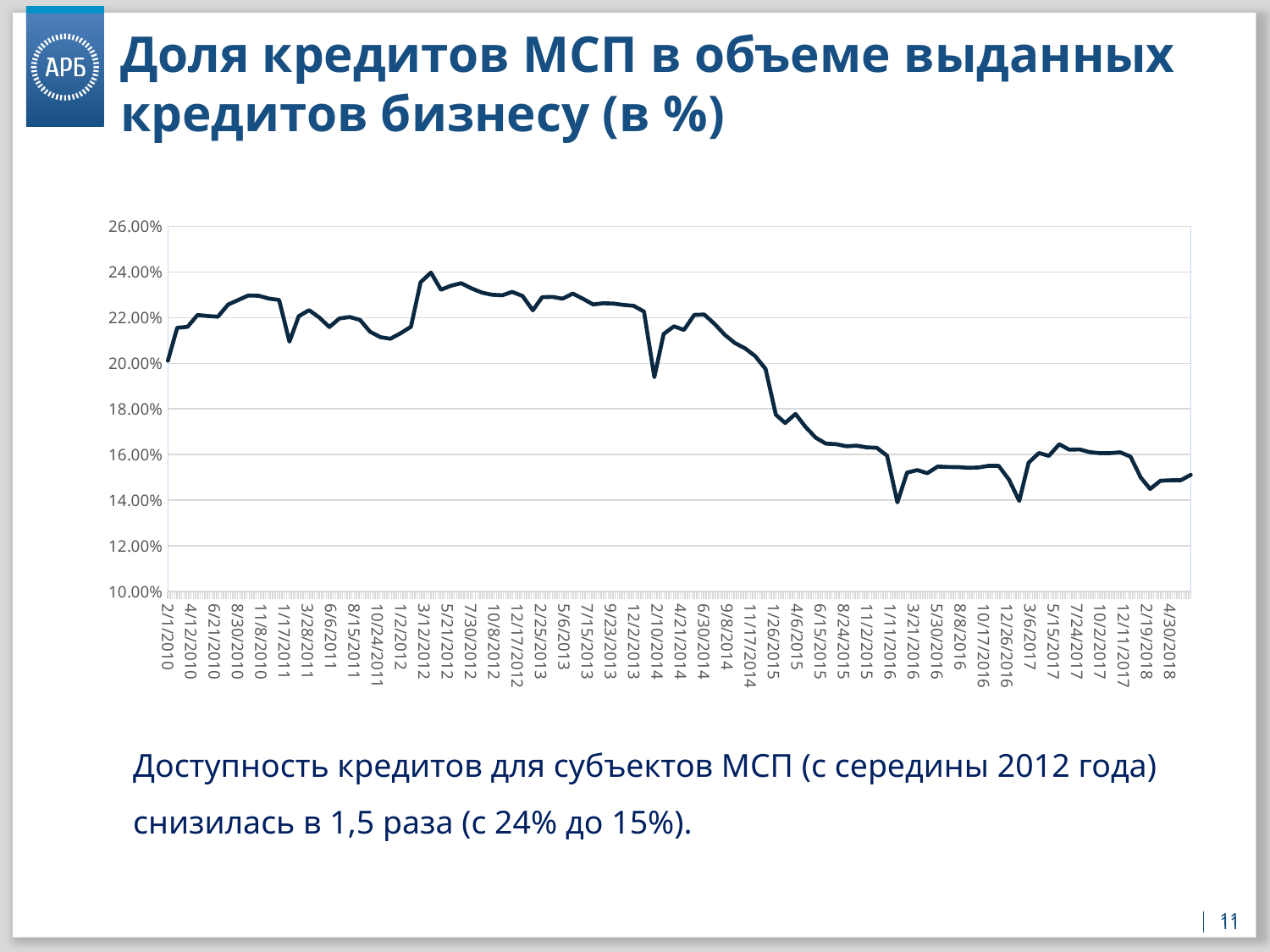
What is the title of the chart on the slide? Доля кредитов МСП в объеме выданных кредитов бизнесу (в %) Is the value for 4/30/2018 greater or less than 16.00%? less What kind of chart is shown on the slide? line chart Is the value for 3/6/2017 greater or less than 16.00%? less Is the value for 5/21/2012 greater or less than 22.00%? greater How many data series are plotted in the chart? 1 What is the highest value shown on the vertical axis? 26.00% Overall, do the values rise or fall from 2/1/2010 to 4/30/2018? fall Which is larger, the value for 7/30/2012 or the value for 8/8/2016? 7/30/2012